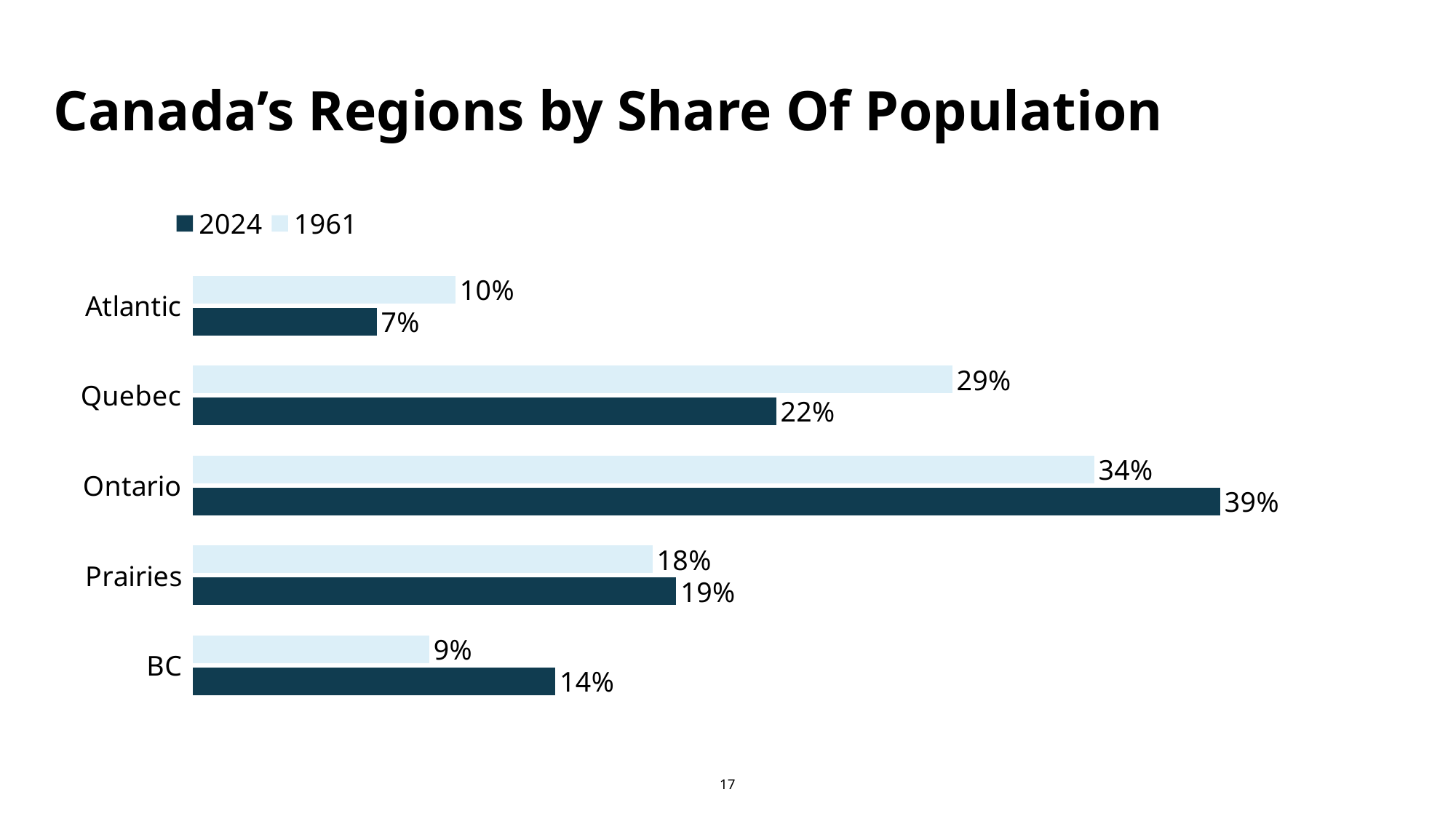
How many series does the legend list? 2 What is the difference between Quebec's 1961 share and its 2024 share? 7% What is the 2024 share of population for BC? 14% Which region has the lowest 1961 share of population? BC How many regions are shown in the chart? 5 What is the 2024 share of population for Ontario? 39% What is the title of the chart? Canada's Regions by Share Of Population Which is larger for the Atlantic region: the 1961 share or the 2024 share? 1961 What was the 1961 share of population for Quebec? 29% What is the difference between Ontario's 2024 share and its 1961 share? 5% What kind of chart is shown on the slide? Bar chart Which region has the highest 2024 share of population? Ontario